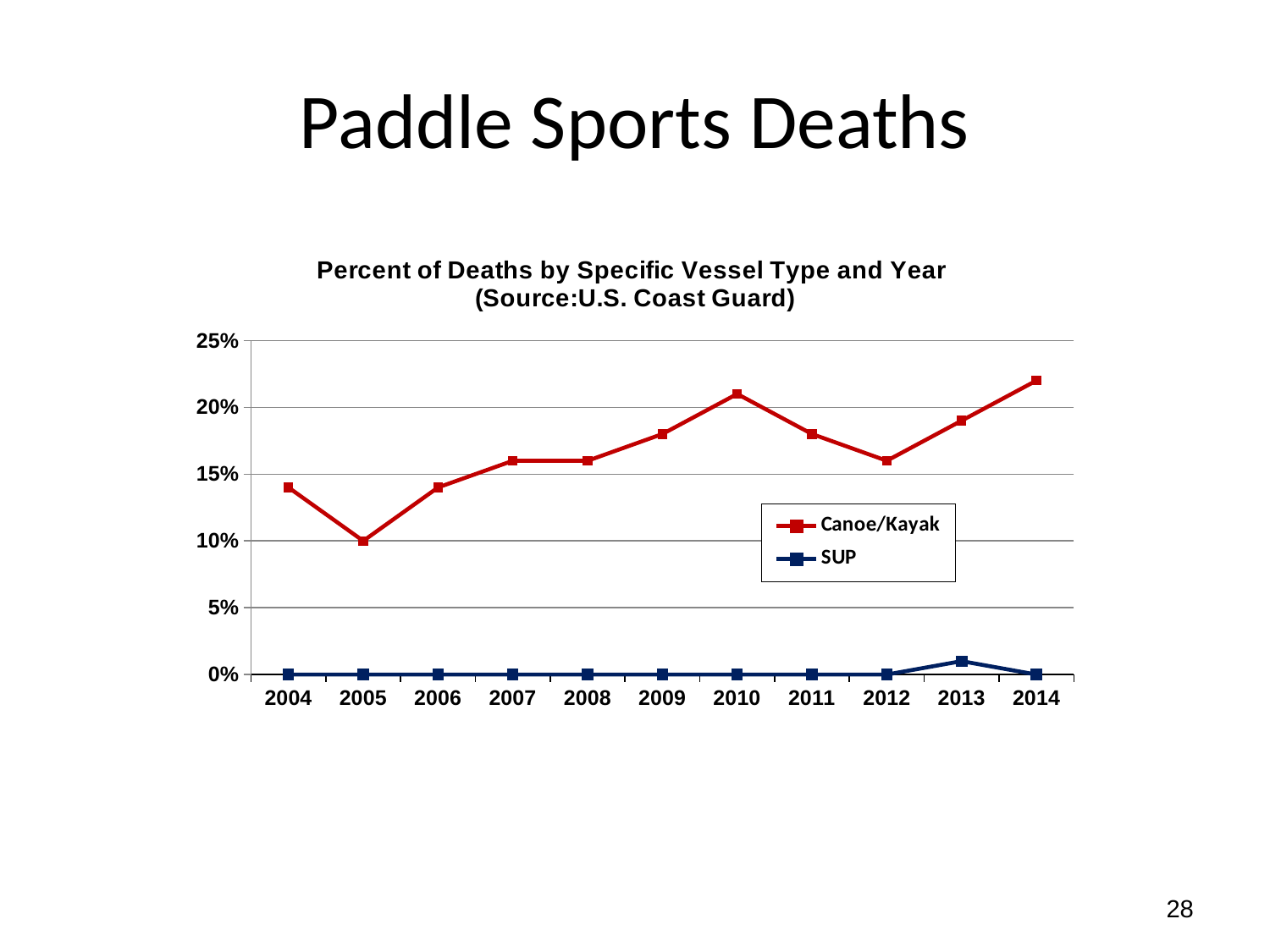
Is the Canoe/Kayak value for 2014 greater or less than 20%? greater Which year has the larger Canoe/Kayak value, 2010 or 2012? 2010 In which year is the Canoe/Kayak value lowest? 2005 What source is cited in the chart title? U.S. Coast Guard What is the SUP value for 2004? 0% Is the Canoe/Kayak value for 2004 greater or less than 15%? less In which year is the SUP value highest? 2013 What kind of chart is shown on the slide? line chart How many years are plotted along the x axis? 11 Does the Canoe/Kayak line rise or fall from 2012 to 2014? rise How many series does the legend list? 2 What is the Canoe/Kayak value for 2005? 10%